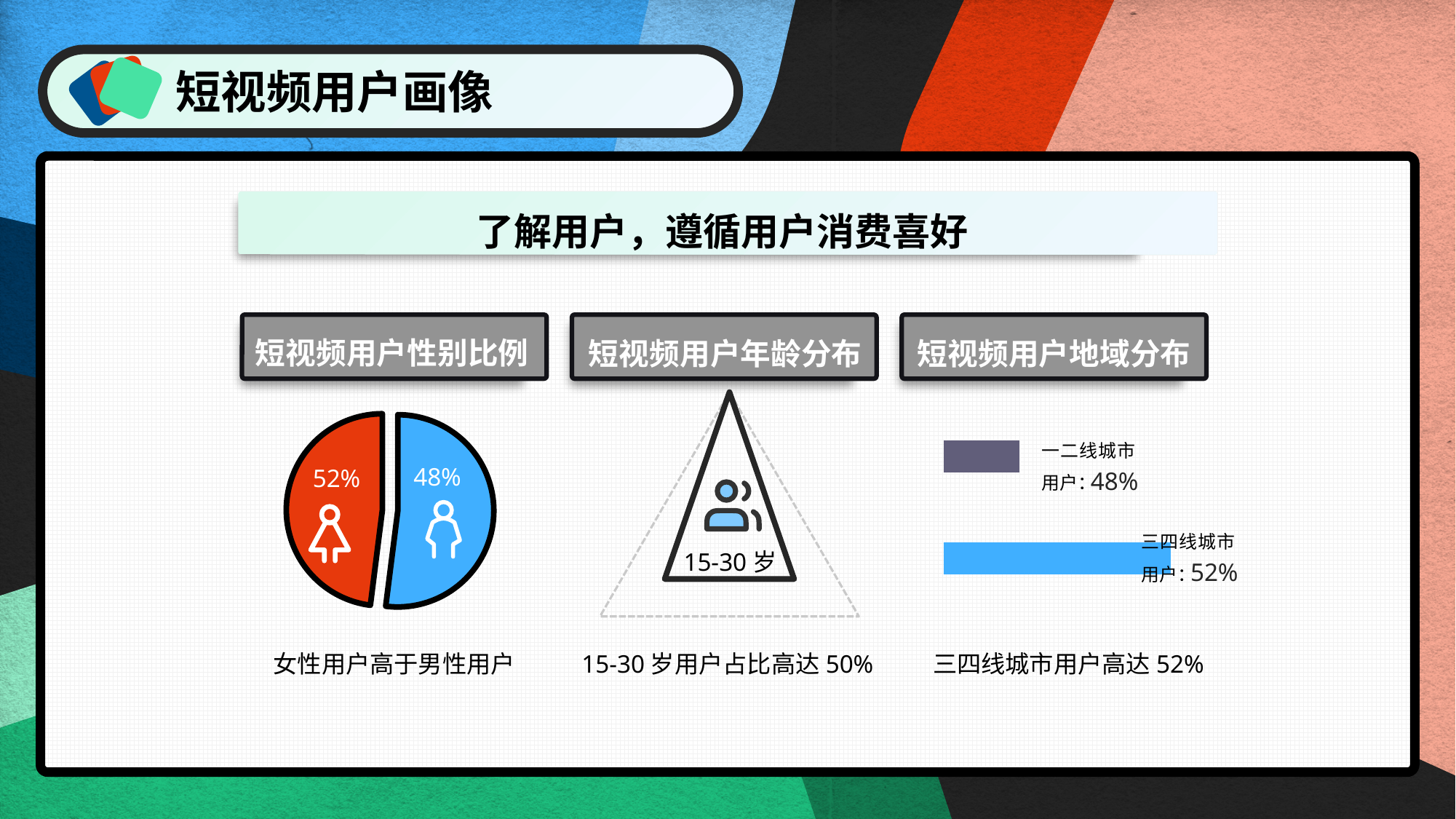
In the 短视频用户年龄分布 graphic, what age group is labelled inside the pyramid? 15-30 岁 In the 短视频用户地域分布 chart, what is the value for 三四线城市用户? 52% In the 短视频用户地域分布 chart, which category has the higher value? 三四线城市用户 In the 短视频用户性别比例 chart, which slice is larger, the female slice or the male slice? female In the 短视频用户地域分布 chart, what is the value for 一二线城市用户? 48% In the 短视频用户性别比例 chart, what share is shown for the female (red) slice? 52% What kind of chart is used for 短视频用户地域分布? bar chart In the 短视频用户性别比例 chart, what share is shown for the male (blue) slice? 48% In the 短视频用户地域分布 chart, what is the difference between 三四线城市用户 and 一二线城市用户? 4% How many slices does the 短视频用户性别比例 pie chart have? 2 In the 短视频用户性别比例 chart, what is the difference between the female share and the male share? 4% What kind of chart is used for 短视频用户性别比例? pie chart